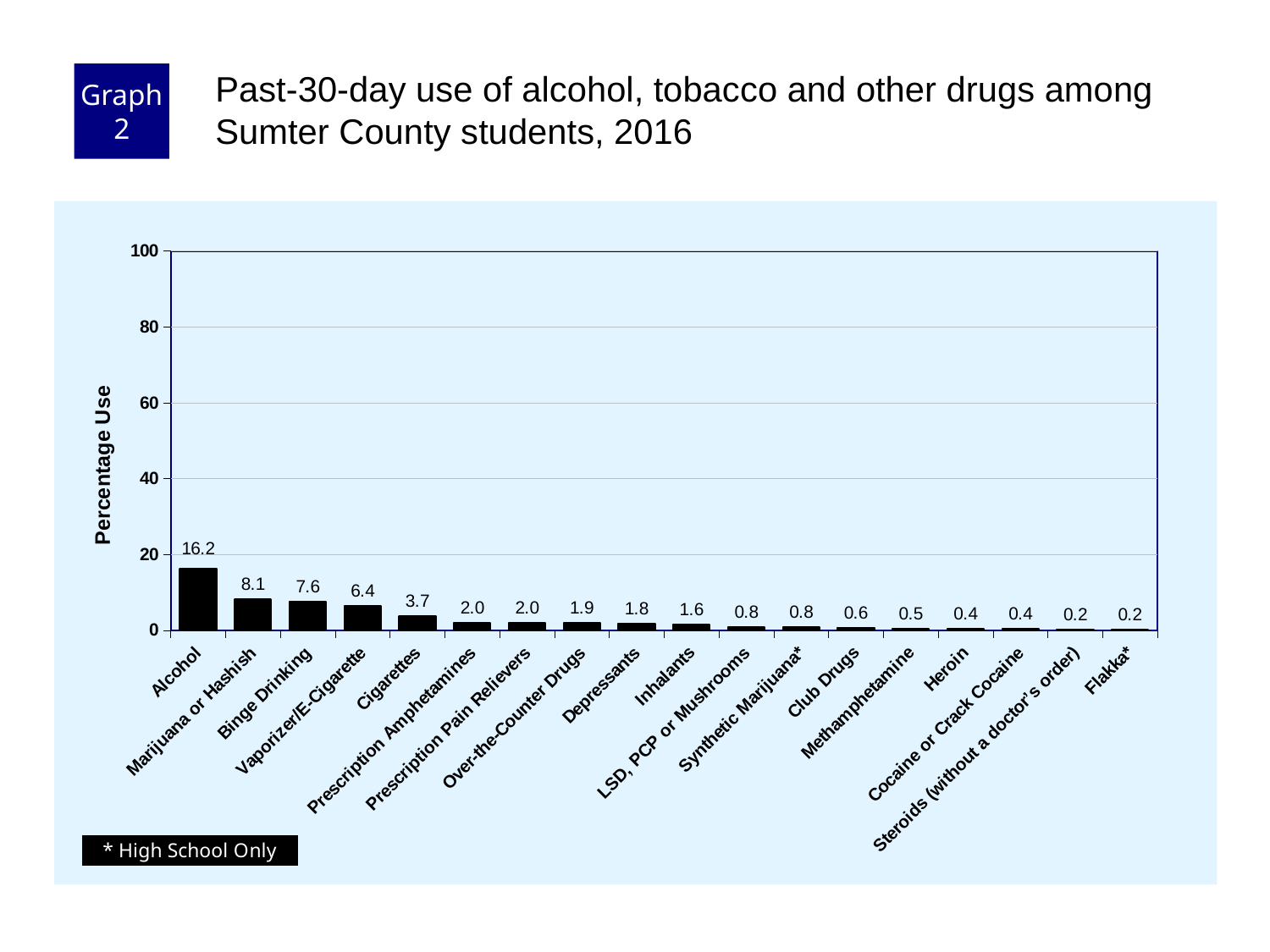
What is the percentage use for Binge Drinking? 7.6 Is the value for Alcohol greater or less than 20? less What is the label of the y axis? Percentage Use Which category has the highest percentage use? Alcohol What kind of chart is shown on the slide? Bar chart How many categories are shown on the x axis? 18 What is the difference in percentage use between Alcohol and Marijuana or Hashish? 8.1 What is the percentage use for Inhalants? 1.6 What is the percentage use for Cigarettes? 3.7 Which has a higher percentage use, Binge Drinking or Vaporizer/E-Cigarette? Binge Drinking What is the difference in percentage use between Vaporizer/E-Cigarette and Cigarettes? 2.7 What is the percentage use for Alcohol? 16.2